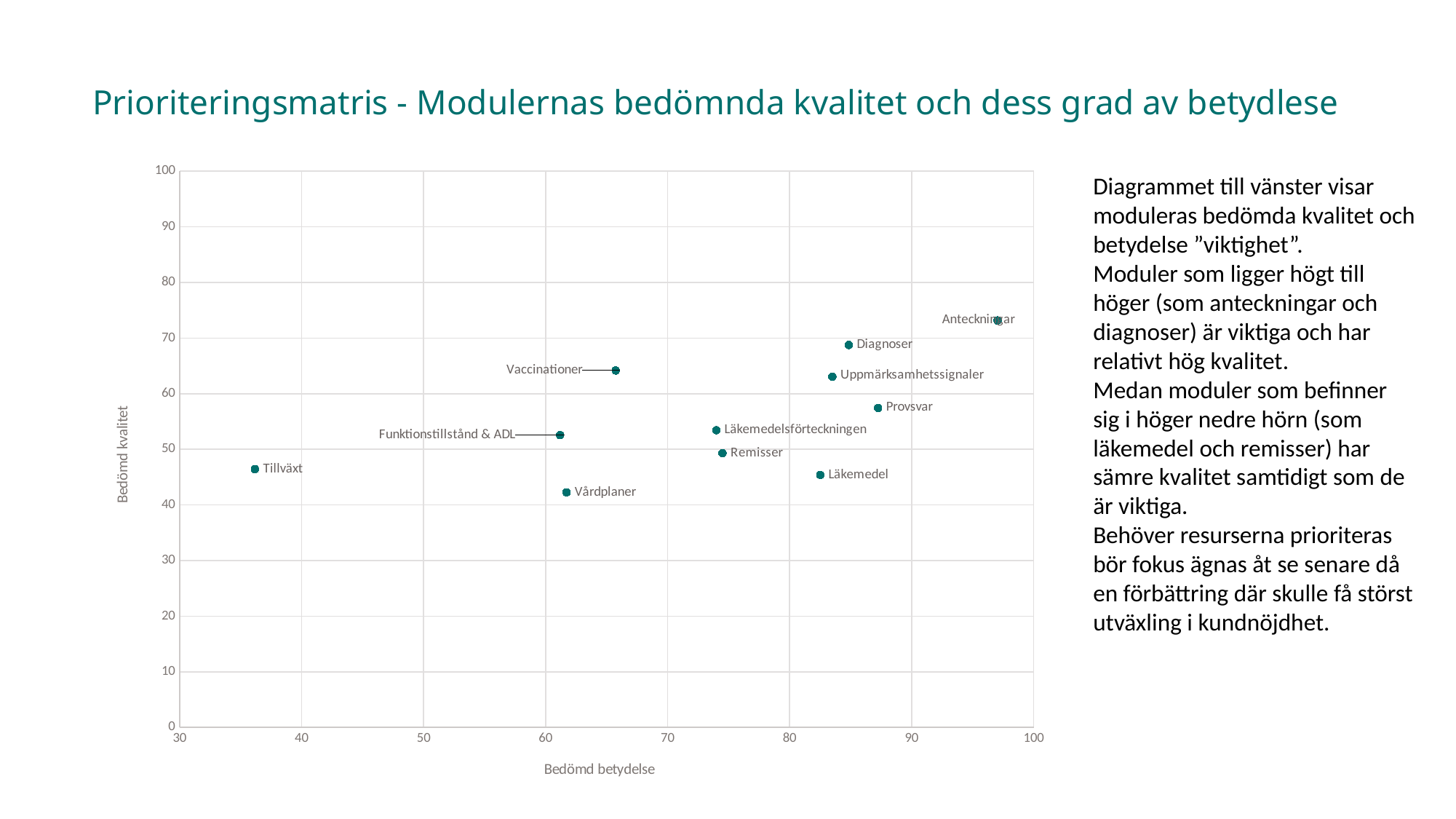
Is the Bedömd kvalitet value for Tillväxt greater or less than 50? less Is the Bedömd betydelse value for Anteckningar greater or less than 90? greater Which module has a higher Bedömd kvalitet value, Diagnoser or Läkemedel? Diagnoser Which module has the highest Bedömd kvalitet value? Anteckningar How many modules (data points) are plotted in the chart? 11 Which module has the lowest Bedömd kvalitet value? Vårdplaner What kind of chart is shown on the slide? scatter chart What is the title of the horizontal axis of the chart? Bedömd betydelse Which module has a higher Bedömd betydelse value, Tillväxt or Provsvar? Provsvar Which module has the highest Bedömd betydelse value? Anteckningar Which module has the lowest Bedömd betydelse value? Tillväxt Is the Bedömd kvalitet value for Vaccinationer greater or less than 60? greater